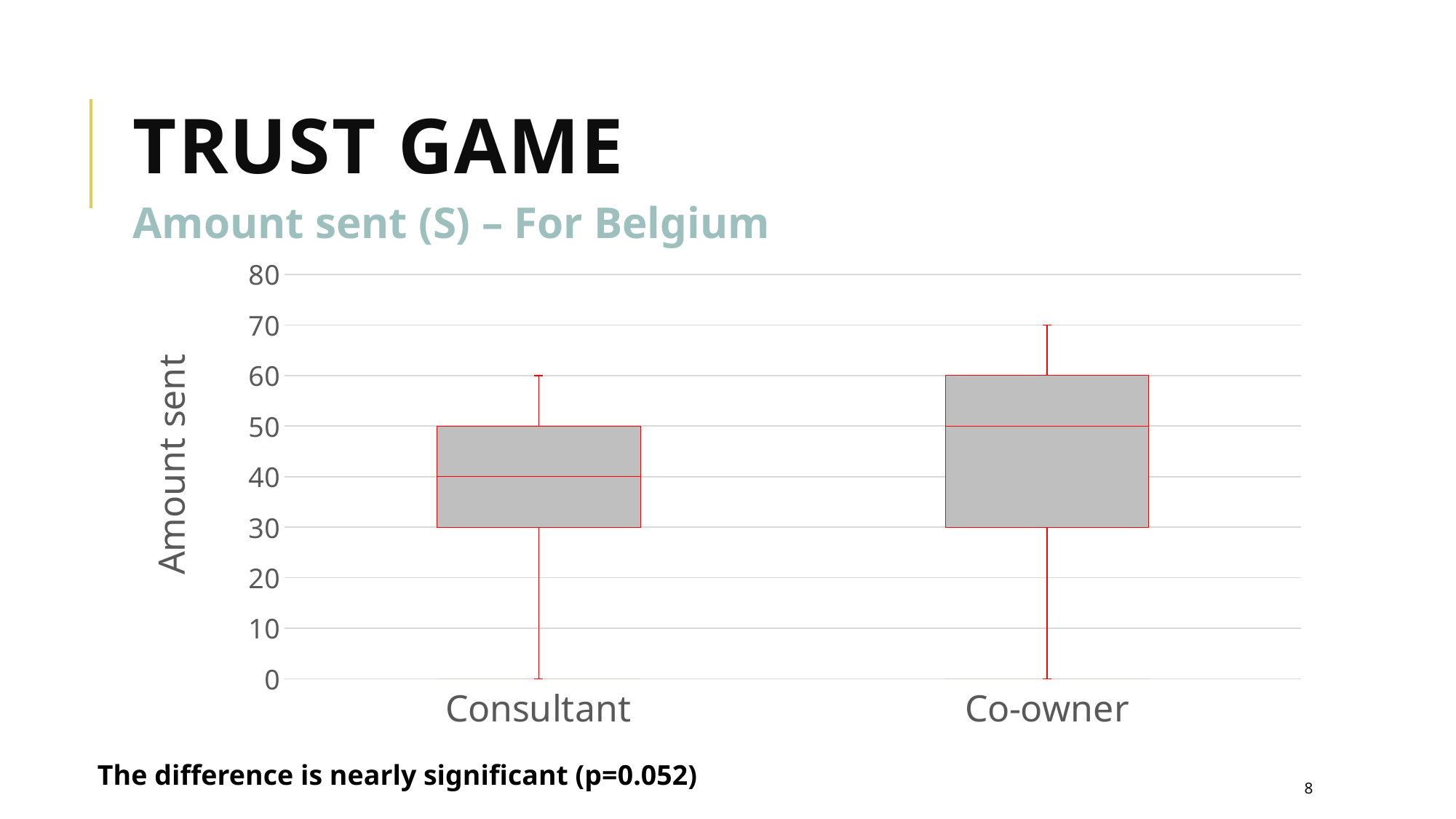
What is the maximum (top whisker) amount sent for Co-owner? 70 What is the difference between the median amount sent for Co-owner and for Consultant? 10 Which category has the higher median amount sent? Co-owner What is the median amount sent for Consultant? 40 What is the median amount sent for Co-owner? 50 What is the bottom of the box (lower quartile) for Consultant? 30 What is the label of the y axis? Amount sent What is the maximum (top whisker) amount sent for Consultant? 60 What kind of chart is shown on the slide? Box plot What is the top of the box (upper quartile) for Co-owner? 60 Is the top whisker for Co-owner greater or less than 60? greater How many categories are shown on the x axis? 2